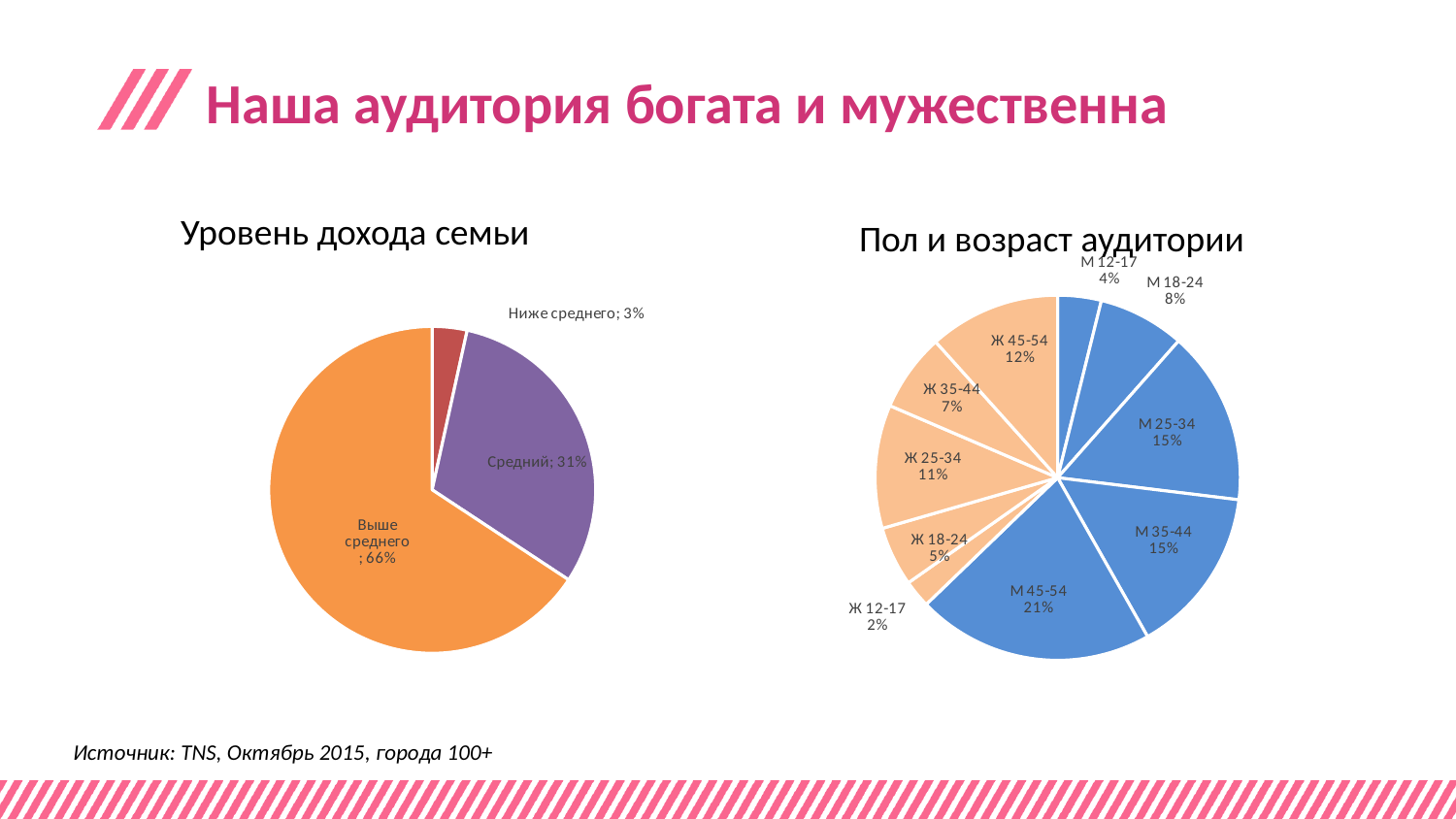
In the chart titled "Уровень дохода семьи", what share is labelled for "Средний"? 31% In the chart titled "Уровень дохода семьи", what is the difference between the shares for "Выше среднего" and "Средний"? 35% In the chart titled "Уровень дохода семьи", which category has the largest slice? Выше среднего In the chart titled "Пол и возраст аудитории", which is larger: the share for "Ж 45-54" or the share for "М 18-24"? Ж 45-54 What kind of chart is the one titled "Пол и возраст аудитории"? Pie chart In the chart titled "Уровень дохода семьи", which category has the smallest slice? Ниже среднего In the chart titled "Пол и возраст аудитории", how many slices does the pie have? 10 In the chart titled "Пол и возраст аудитории", what is the difference between the shares for "М 45-54" and "Ж 18-24"? 16% In the chart titled "Уровень дохода семьи", how many slices does the pie have? 3 In the chart titled "Пол и возраст аудитории", what share is labelled for "Ж 25-34"? 11% In the chart titled "Пол и возраст аудитории", what share is labelled for "М 45-54"? 21% In the chart titled "Пол и возраст аудитории", which category has the smallest slice? Ж 12-17